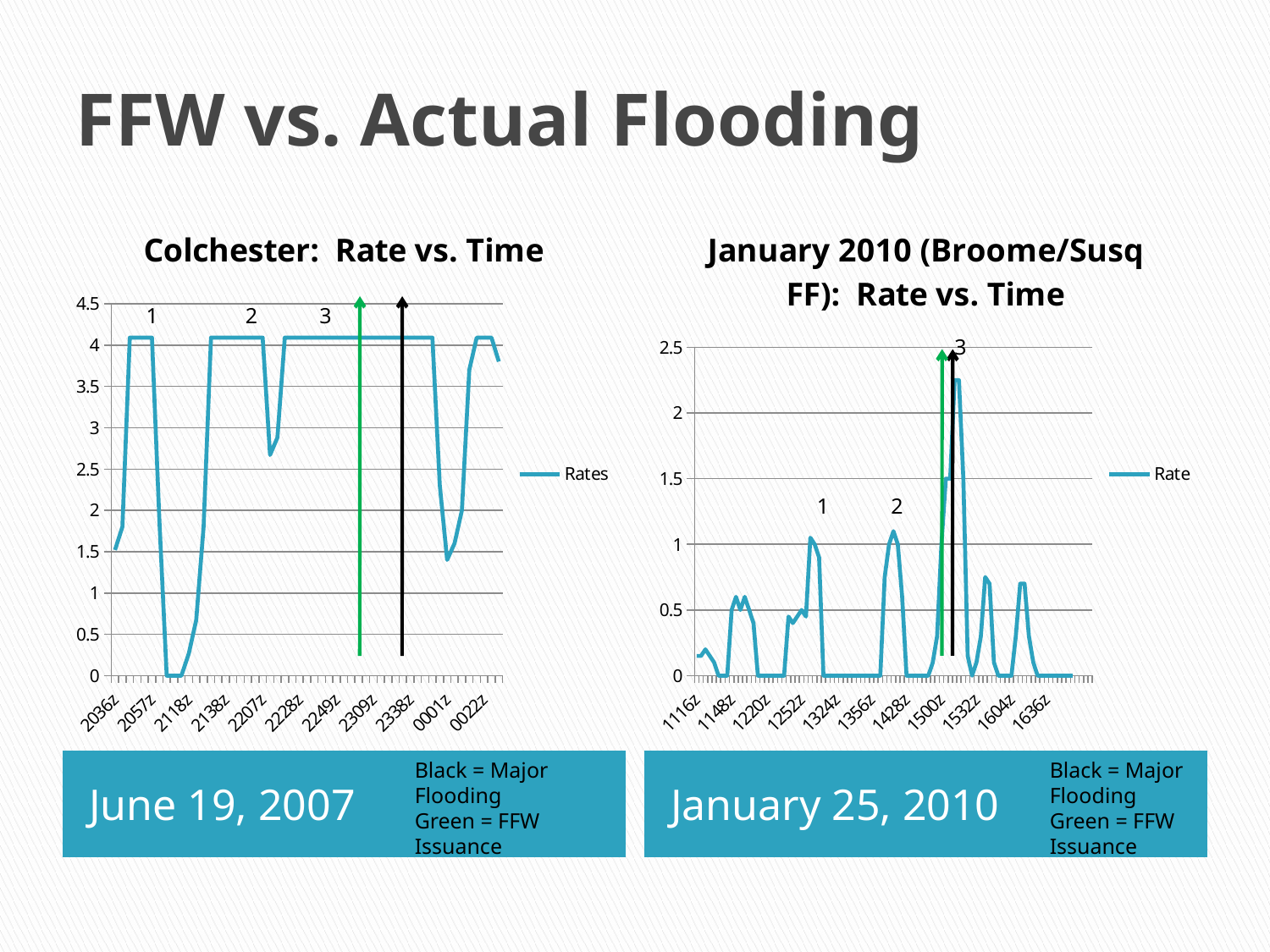
How many series does the legend of the Colchester: Rate vs. Time chart list? 1 In the Colchester: Rate vs. Time chart, is the value at 2338z greater or less than 2? greater What kind of chart is the January 2010 (Broome/Susq FF): Rate vs. Time chart? line chart In the January 2010 (Broome/Susq FF): Rate vs. Time chart, is the value at 1604z greater or less than 1? less What is the legend entry on the January 2010 (Broome/Susq FF): Rate vs. Time chart? Rate In the January 2010 (Broome/Susq FF): Rate vs. Time chart, is the peak value near 1500z greater or less than 2? greater How many time labels are shown on the x axis of the January 2010 (Broome/Susq FF): Rate vs. Time chart? 11 According to the slide, what does the green arrow on each chart represent? FFW Issuance What kind of chart is the Colchester: Rate vs. Time chart? line chart